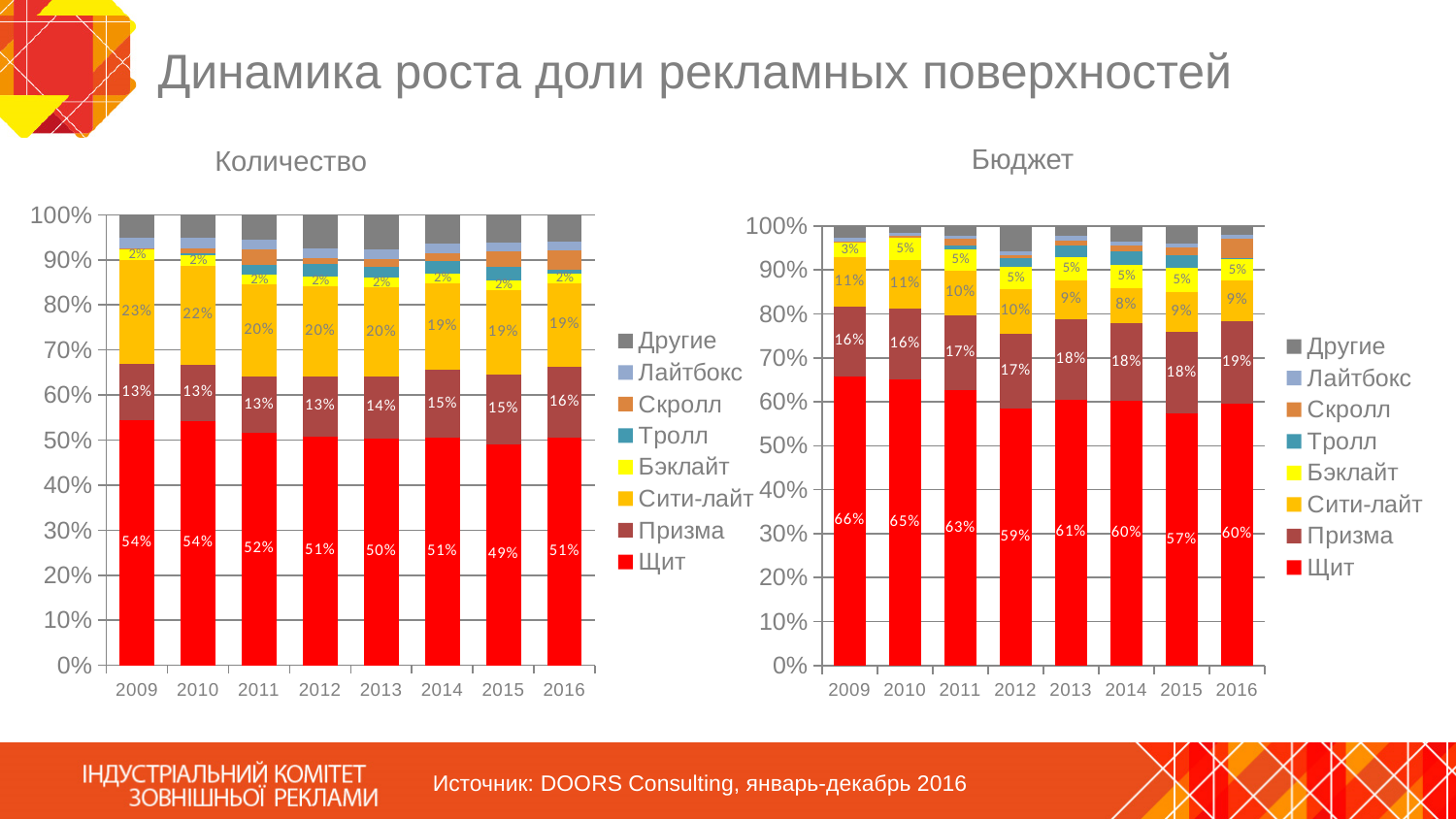
In the "Бюджет" chart, what is the value for Призма in 2016? 19% In the "Количество" chart, what is the value for Щит in 2009? 54% In the "Бюджет" chart, what is the difference between the Щит values for 2009 and 2016? 6% How many years are shown on the x axis of the "Бюджет" chart? 8 In the "Бюджет" chart, does the value for Призма rise or fall from 2009 to 2016? Rise How many series does the legend of the "Количество" chart list? 8 What kind of chart is the "Бюджет" chart? Stacked bar chart In the "Бюджет" chart, which year has the highest value for Щит? 2009 In the "Количество" chart, what is the value for Сити-лайт in 2010? 22% In the "Количество" chart, which year has the lowest value for Щит? 2015 In the "Количество" chart, which is larger: Сити-лайт in 2009 or Сити-лайт in 2016? Сити-лайт in 2009 In the "Бюджет" chart, what is the value for Щит in 2015? 57%